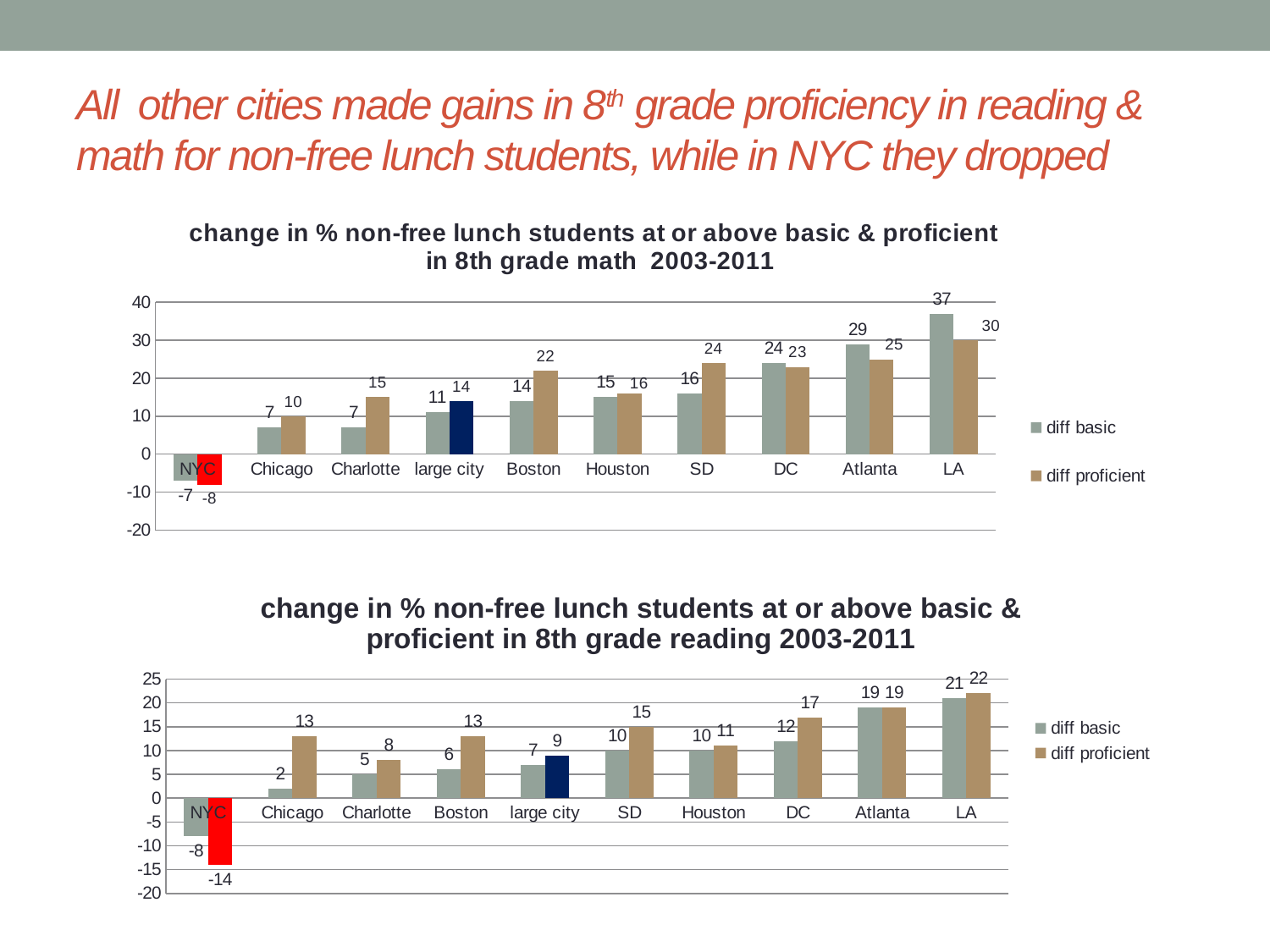
In the 8th grade reading chart, which city has the highest diff proficient value? LA In the 8th grade math chart, which city has the lowest diff basic value? NYC How many series does the legend of the 8th grade math chart list? 2 In the 8th grade math chart, what is the diff basic value for LA? 37 What kind of chart is the 8th grade math chart? bar chart In the 8th grade reading chart, what is the diff basic value for Chicago? 2 How many cities or categories are shown on the x axis of the 8th grade reading chart? 10 In the 8th grade math chart, what is the diff proficient value for NYC? -8 In the 8th grade math chart, what is the difference between the diff basic and diff proficient values for Boston? 8 In the 8th grade reading chart, which is larger for Boston: diff basic or diff proficient? diff proficient In the 8th grade math chart, what is the difference between the diff proficient values for LA and Chicago? 20 In the 8th grade reading chart, what is the diff proficient value for NYC? -14